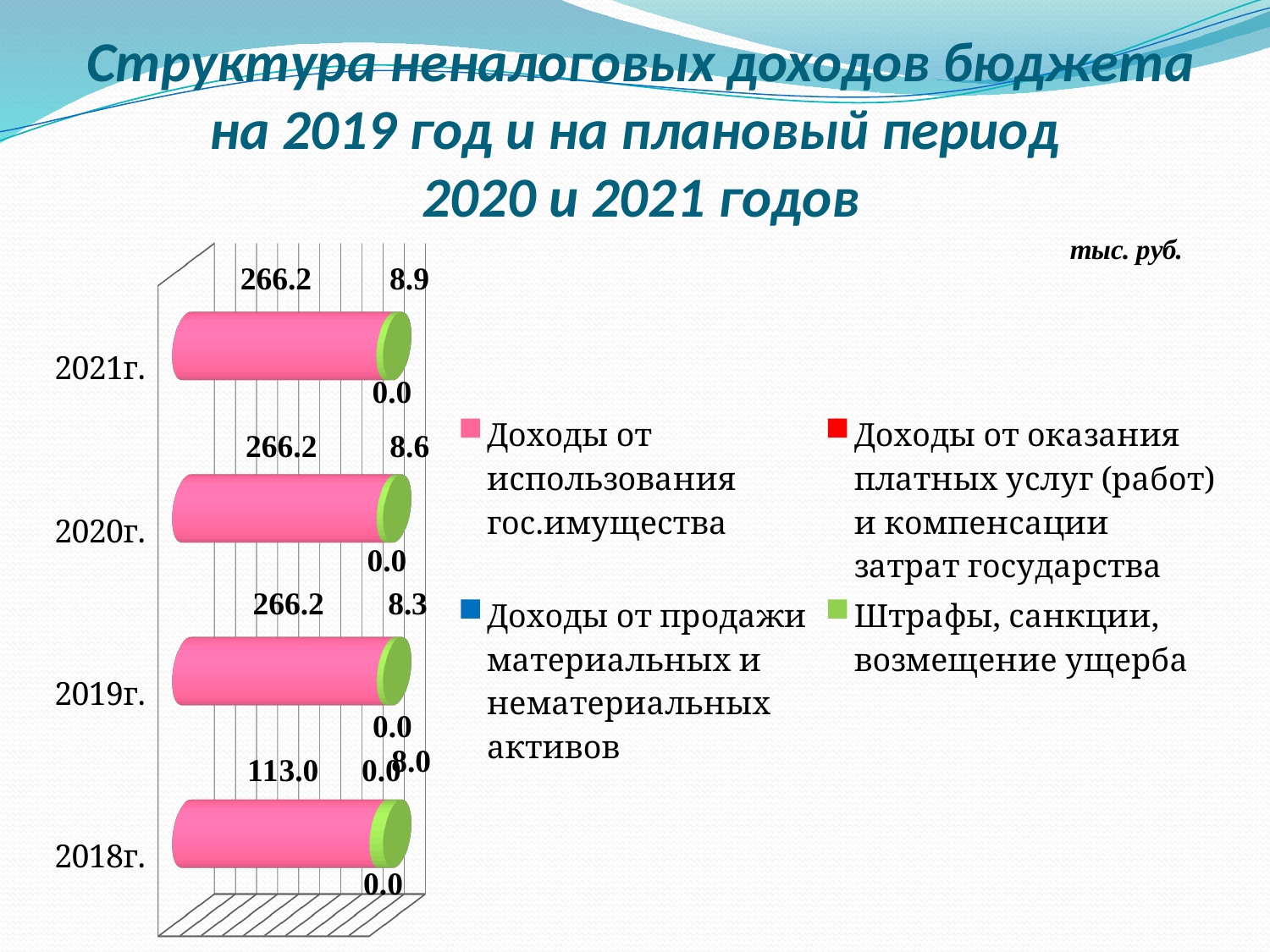
How many series does the legend list? 4 What is the difference between the 'Доходы от использования гос.имущества' values for 2019г. and 2018г.? 153.2 What type of chart is shown on the slide? bar chart What is the value for 'Доходы от использования гос.имущества' in 2018г.? 113.0 What is the difference between the 'Штрафы, санкции, возмещение ущерба' values for 2021г. and 2019г.? 0.6 What is the value for 'Штрафы, санкции, возмещение ущерба' in 2020г.? 8.6 In which year is the value for 'Штрафы, санкции, возмещение ущерба' the lowest? 2018г. In which year is the value for 'Доходы от использования гос.имущества' the lowest? 2018г. What is the value for 'Штрафы, санкции, возмещение ущерба' in 2019г.? 8.3 How many years (categories) are shown on the chart? 4 What is the value for 'Доходы от использования гос.имущества' in 2021г.? 266.2 Do the values for 'Штрафы, санкции, возмещение ущерба' rise or fall from 2018г. to 2021г.? rise